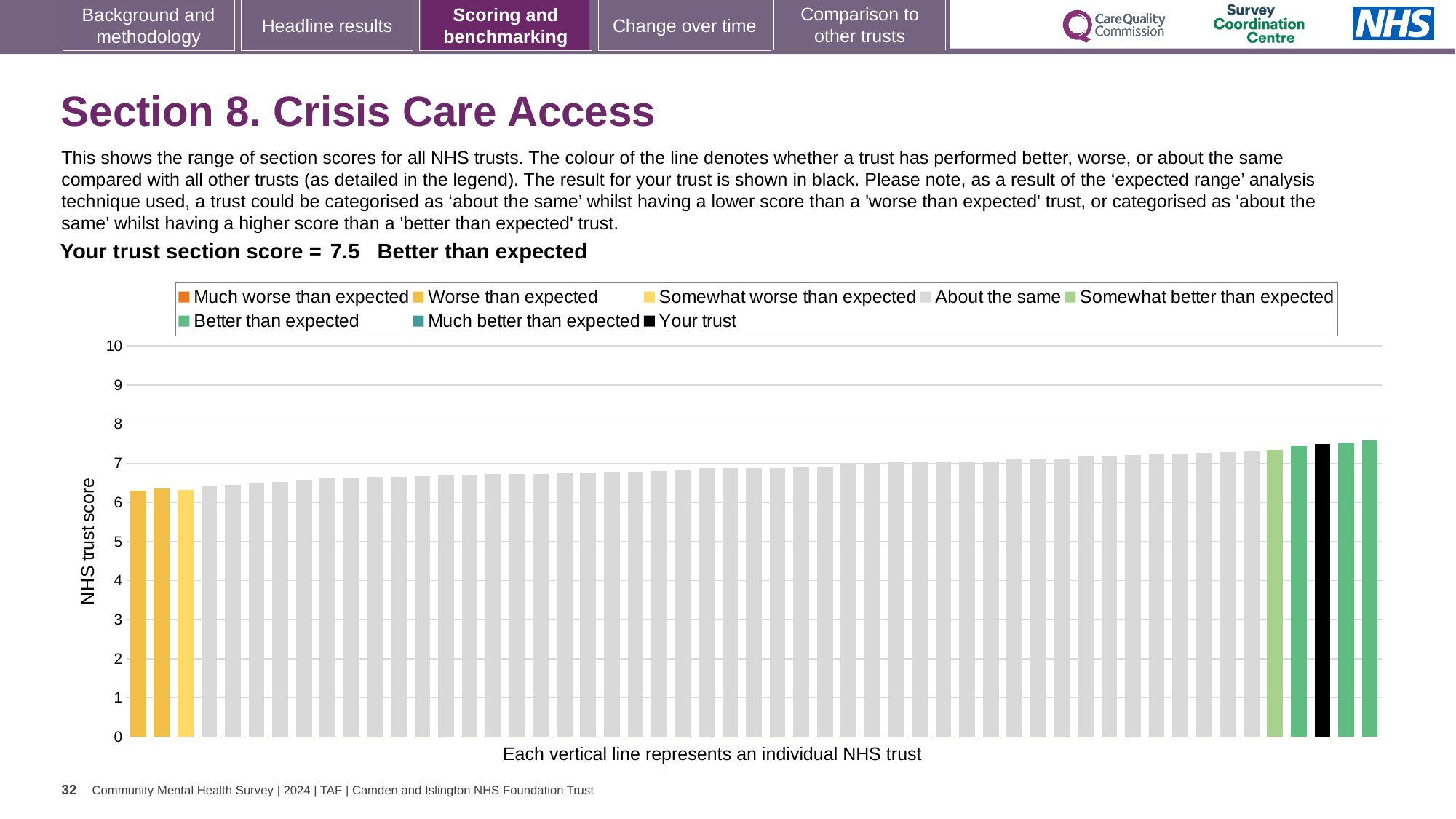
Is the lowest bar in the chart greater or less than 6? greater How many bars are coloured as 'Better than expected' (green), excluding the black bar? 3 What colour is the bar representing your trust? black Do the bar values rise or fall from left to right along the x axis? rise How many bars are coloured as 'Worse than expected' (yellow)? 2 What kind of chart is shown on the slide? bar chart Is the value for your trust greater or less than 7? greater What is the label on the vertical axis of the chart? NHS trust score What is the section score for your trust shown on the slide? 7.5 Which performance category is your trust's section score assigned to? Better than expected How many entries does the chart legend list? 8 Is the highest bar in the chart greater or less than 8? less